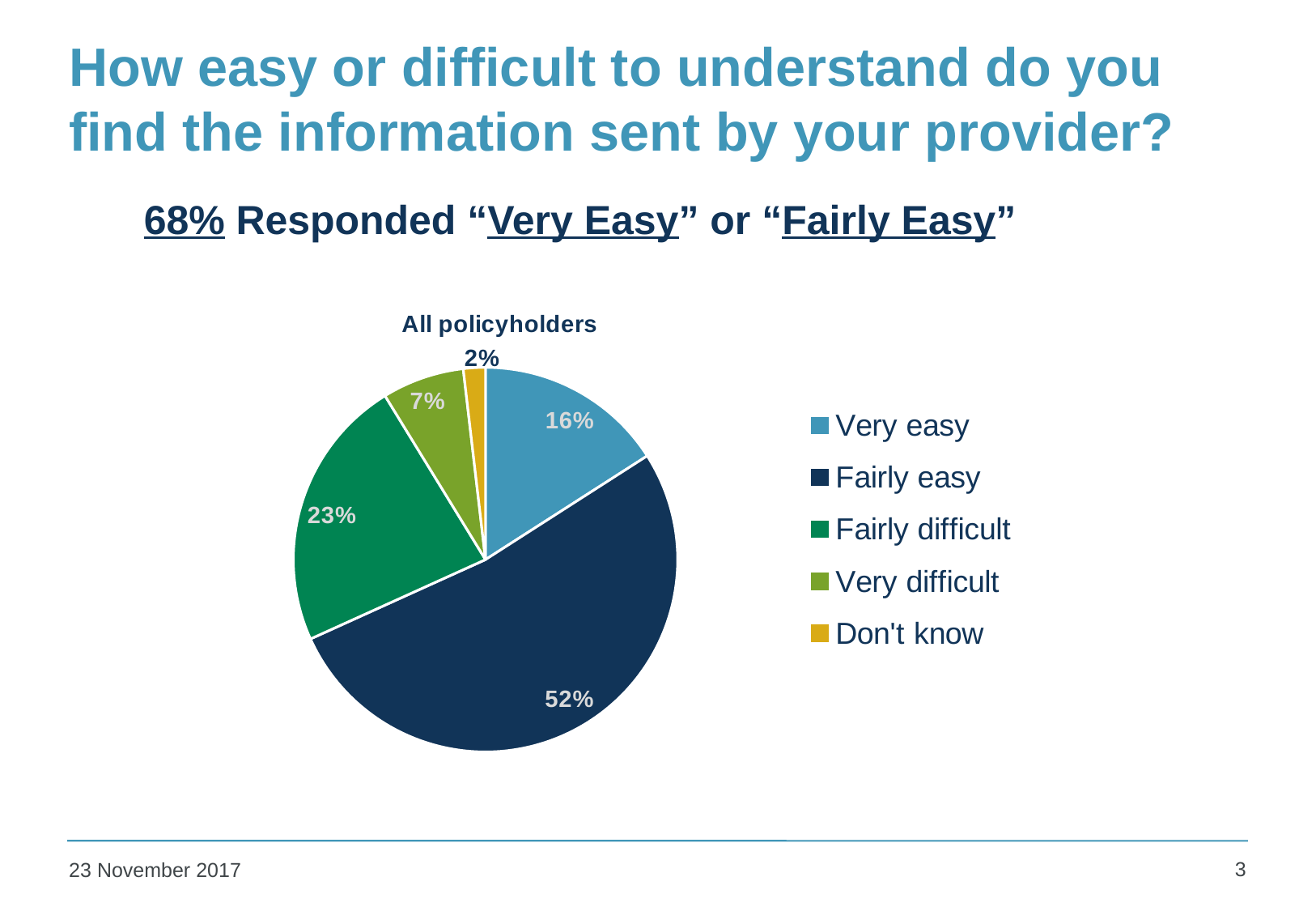
What is the chart's title? All policyholders What is the difference in percentage points between "Fairly easy" and "Fairly difficult"? 29 Which response has the smallest share of the pie? Don't know What percentage of policyholders responded "Don't know"? 2% What percentage of policyholders responded "Fairly difficult"? 23% Which response has the largest share of the pie? Fairly easy What percentage of policyholders responded "Very easy"? 16% What percentage of policyholders responded "Fairly easy"? 52% What percentage of policyholders responded "Very difficult"? 7% Which is larger, the share for "Very easy" or the share for "Fairly difficult"? Fairly difficult How many categories does the legend list? 5 What type of chart is shown on the slide? pie chart